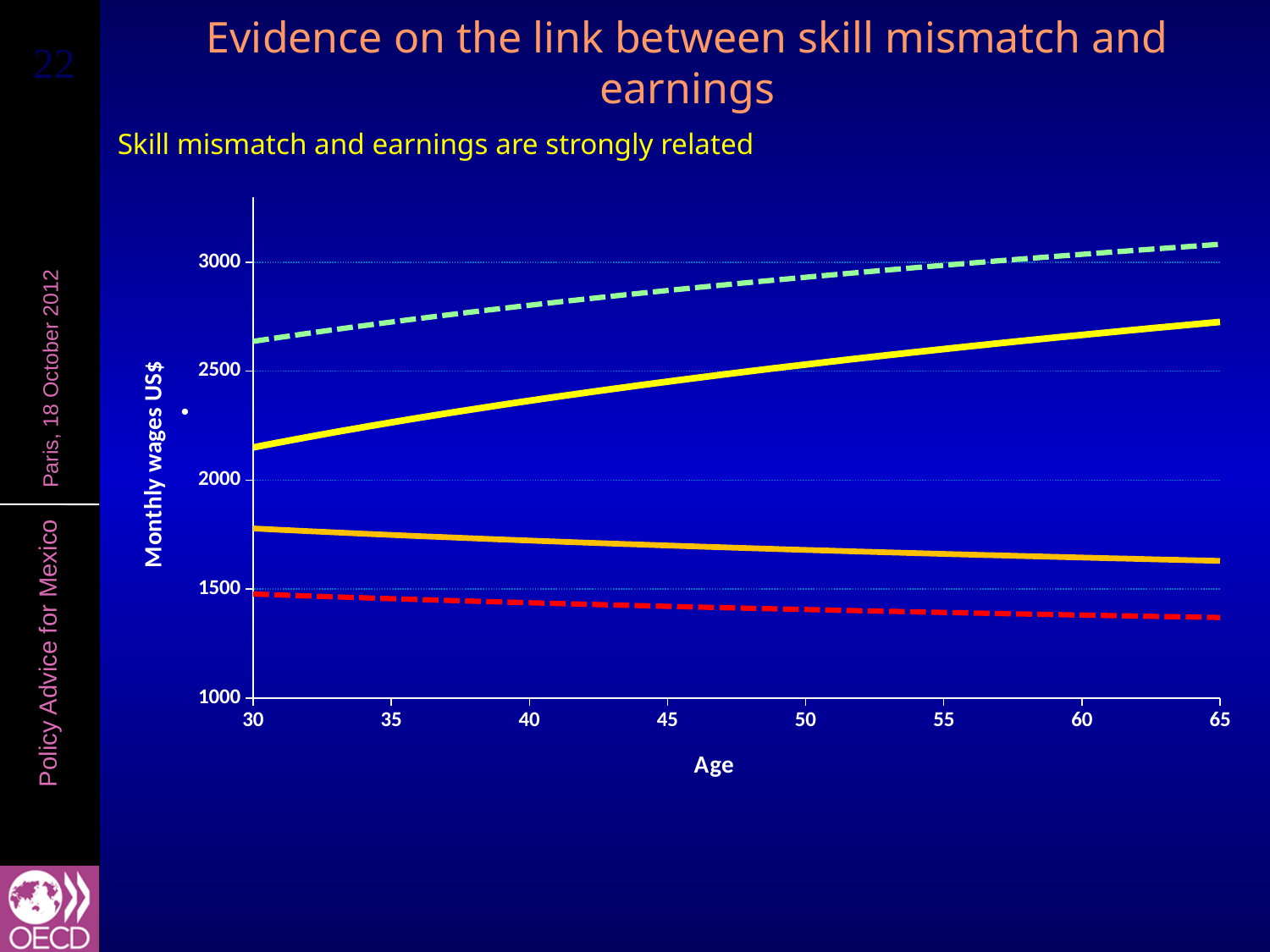
At age 65, which line is higher: the yellow solid line or the orange solid line? yellow solid line Does the red dashed line rise or fall as age increases from 30 to 65? fall Is the value of the green dashed line at age 65 greater or less than 3000? greater What kind of chart is shown on the slide? line chart Does the orange solid line rise or fall as age increases from 30 to 65? fall What is the label of the vertical axis? Monthly wages US$ How many lines are plotted on the chart? 4 Does the green dashed line rise or fall as age increases from 30 to 65? rise Is the value of the yellow solid line at age 30 greater or less than 2000? greater What is the label of the horizontal axis? Age